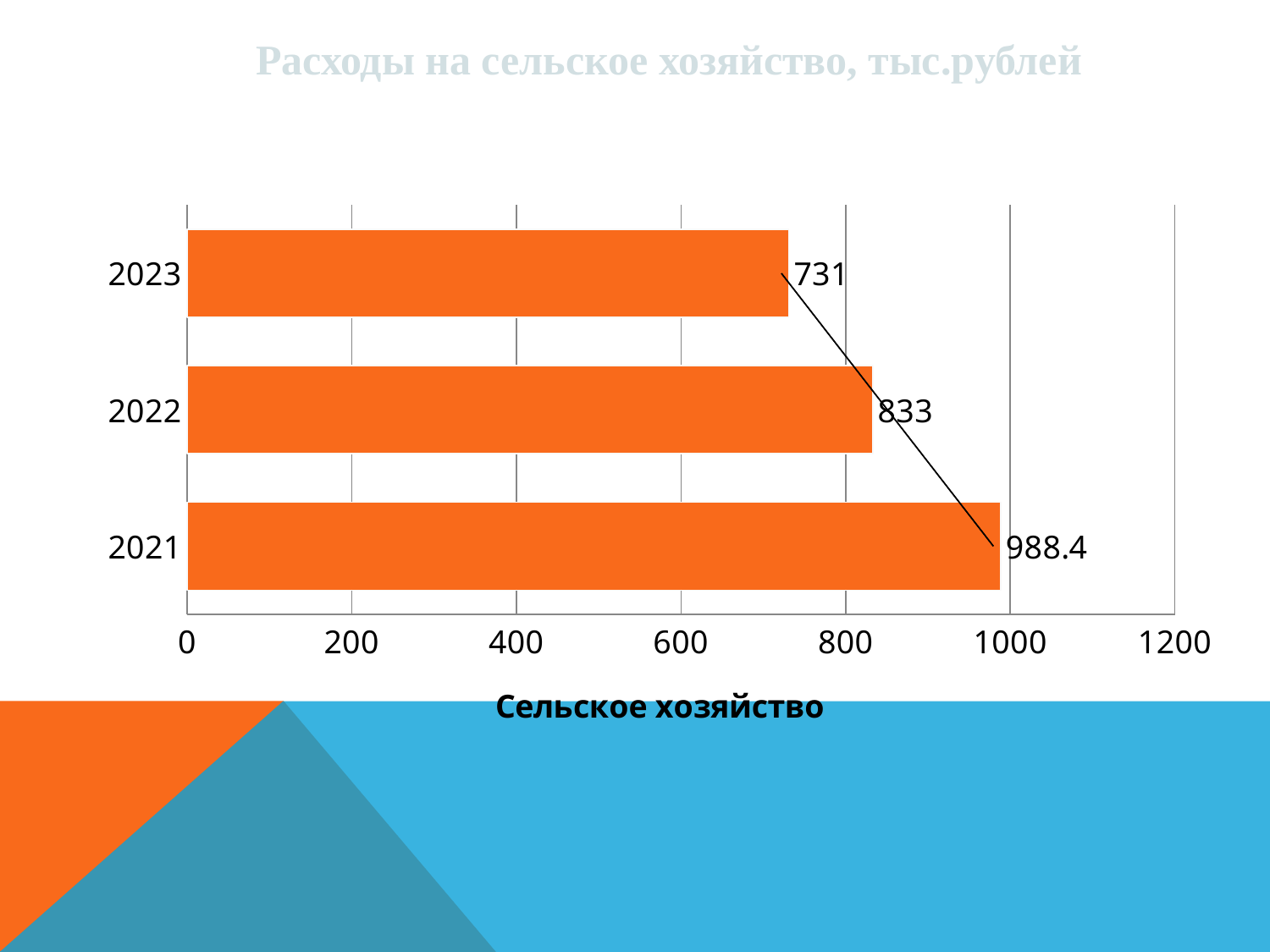
What is the difference between the values for 2022 and 2023? 102 Is the value for 2023 greater or less than 800? less What kind of chart is shown on the slide? bar chart What is the value for 2021? 988.4 Which is larger, the value for 2021 or the value for 2023? 2021 What is the title of the chart? Расходы на сельское хозяйство, тыс.рублей What is the value for 2023? 731 Which year has the lowest value? 2023 Which year has the highest value? 2021 What is the difference between the values for 2021 and 2022? 155.4 How many years are shown in the chart? 3 What is the value for 2022? 833